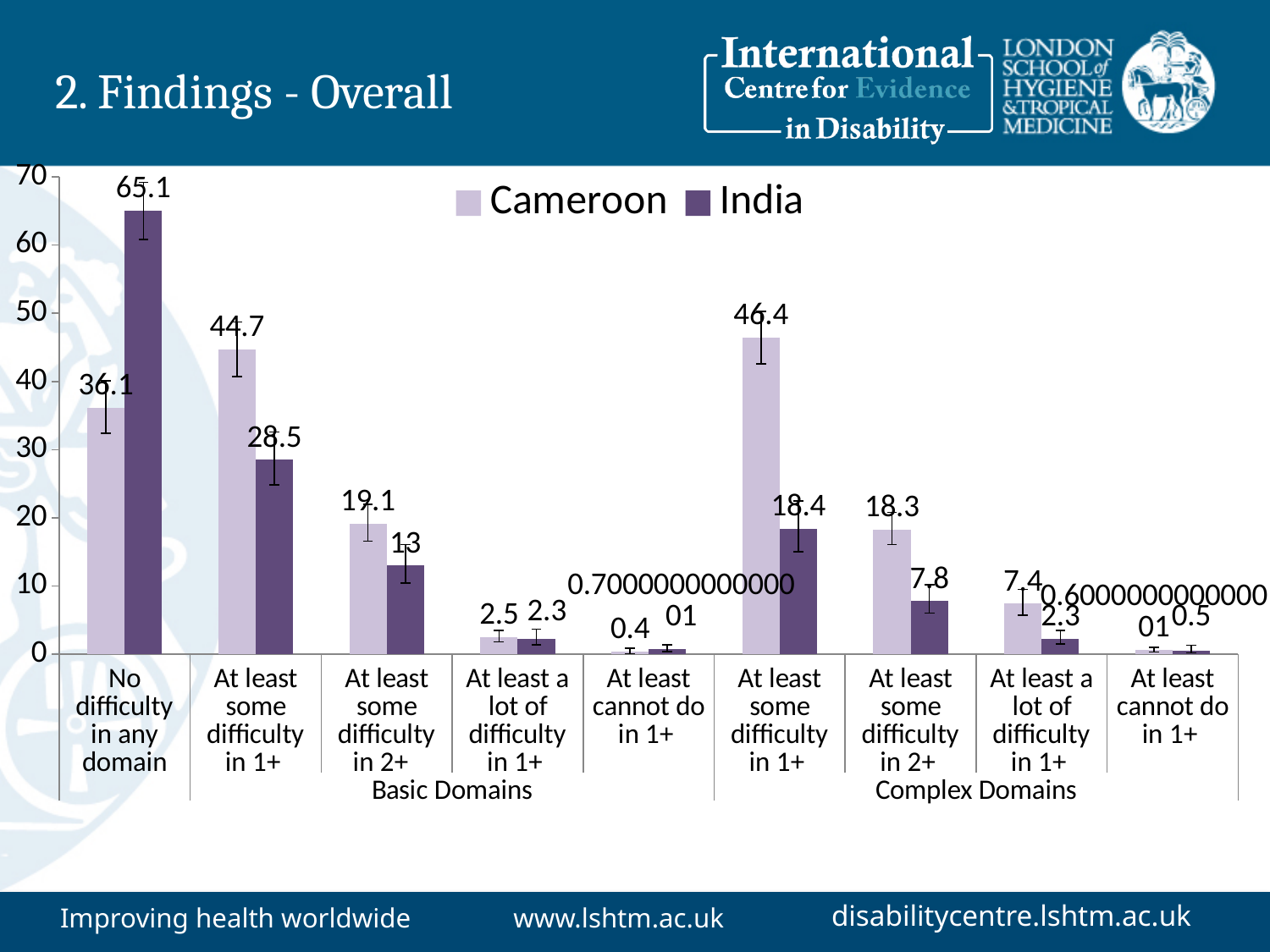
For 'At least some difficulty in 1+' in the Basic Domains, which country has the larger value? Cameroon What is the value for India in the 'No difficulty in any domain' category? 65.1 How many categories are shown along the x axis? 9 What is the value for Cameroon for 'At least some difficulty in 1+' in the Complex Domains? 46.4 What is the difference between Cameroon and India for 'At least some difficulty in 1+' in the Complex Domains? 28 How many series does the legend list? 2 What is the value for India for 'At least some difficulty in 2+' in the Basic Domains? 13 What is the value for India for 'At least some difficulty in 2+' in the Complex Domains? 7.8 What is the difference between India and Cameroon in the 'No difficulty in any domain' category? 29 Which bar is the highest in the chart? India, No difficulty in any domain What kind of chart is shown on the slide? Bar chart What is the value for Cameroon for 'At least some difficulty in 1+' in the Basic Domains? 44.7